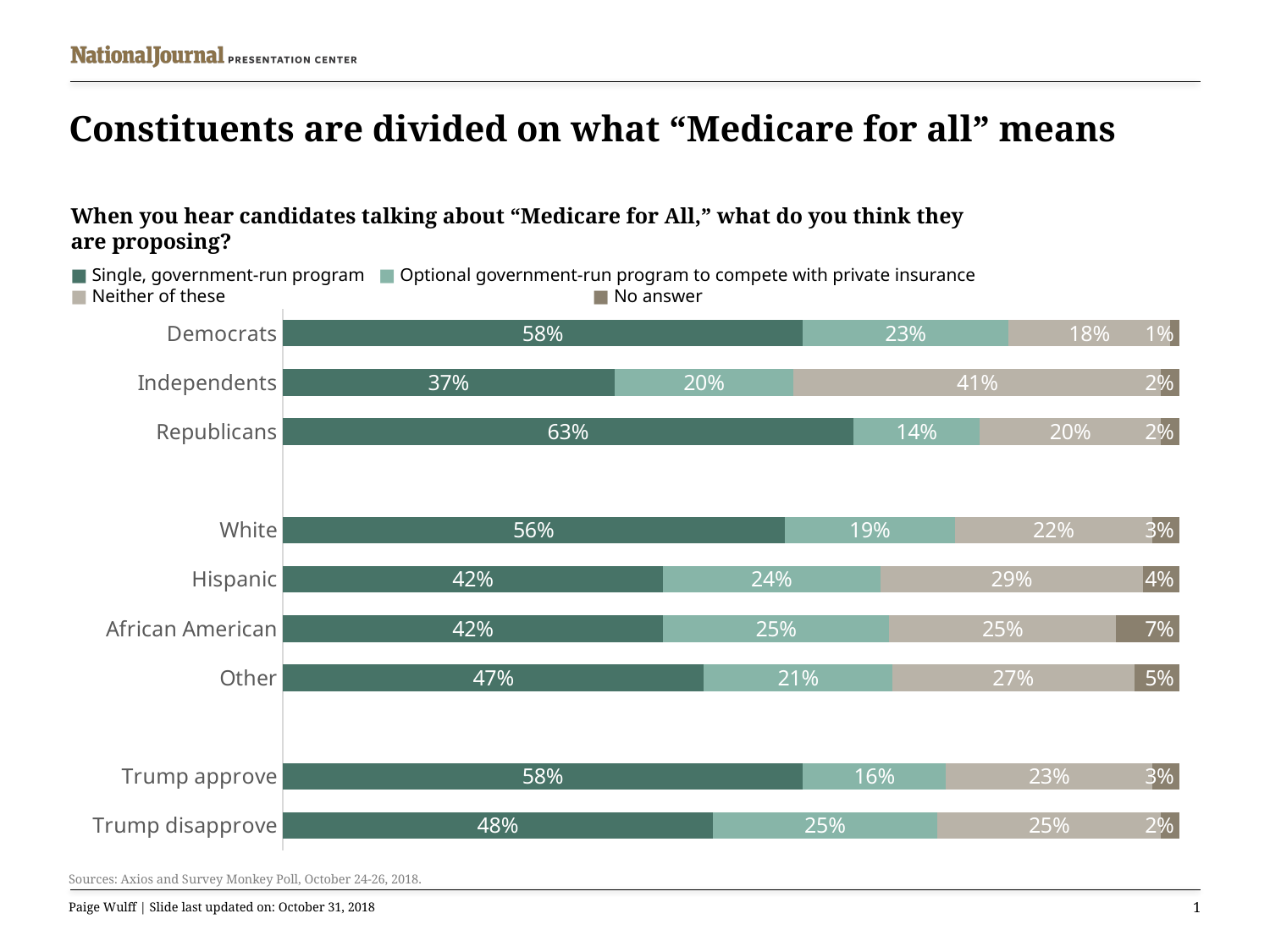
Which group has the highest "No answer" share? African American What percentage of Republicans think candidates are proposing a single, government-run program? 63% What percentage of Independents answered "Neither of these"? 41% What percentage of Trump approvers think candidates are proposing an optional government-run program to compete with private insurance? 16% How many response categories does the legend list? 4 How many percentage points higher is the "Single, government-run program" share for Democrats than for Independents? 21 percentage points What kind of chart is shown on the slide? Stacked bar chart Which group has the highest share saying "Single, government-run program"? Republicans Which group has the lowest share saying "Single, government-run program"? Independents How many groups (bars) are shown in the chart? 9 Which group has a larger share for "Optional government-run program to compete with private insurance": Hispanic or White? Hispanic What is the total of the four labelled segments for Republicans? 99%